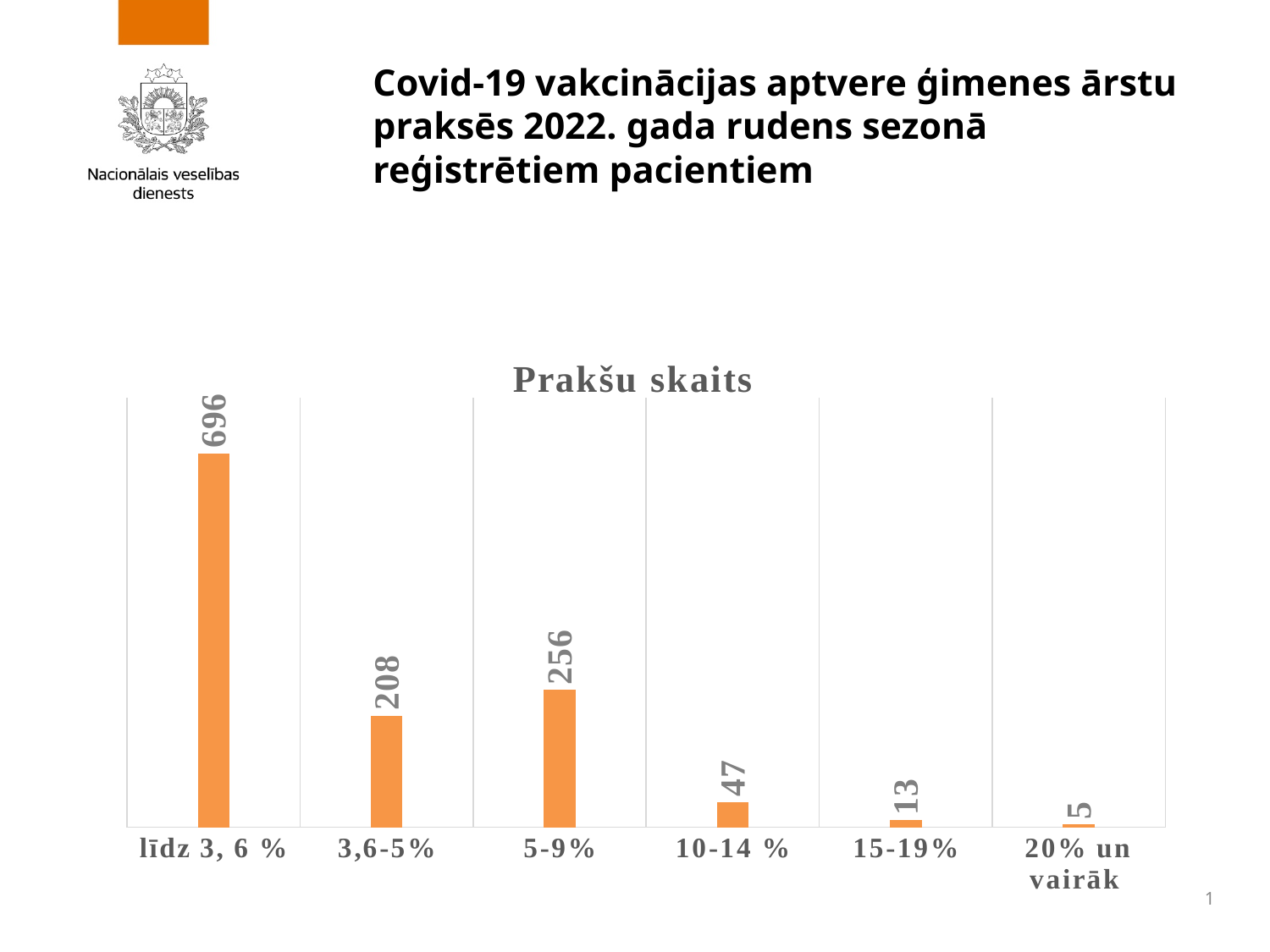
What is the title of the chart? Prakšu skaits What is the value for the "līdz 3, 6 %" category? 696 How many categories are shown on the x axis? 6 What is the value for the "15-19%" category? 13 What kind of chart is shown on the slide? bar chart What is the value for the "5-9%" category? 256 Which is larger, the value for "3,6-5%" or the value for "5-9%"? 5-9% What is the value for the "20% un vairāk" category? 5 What is the difference between the values for "līdz 3, 6 %" and "10-14 %"? 649 Which category has the lowest value? 20% un vairāk What is the difference between the values for "5-9%" and "3,6-5%"? 48 Which category has the highest value? līdz 3, 6 %